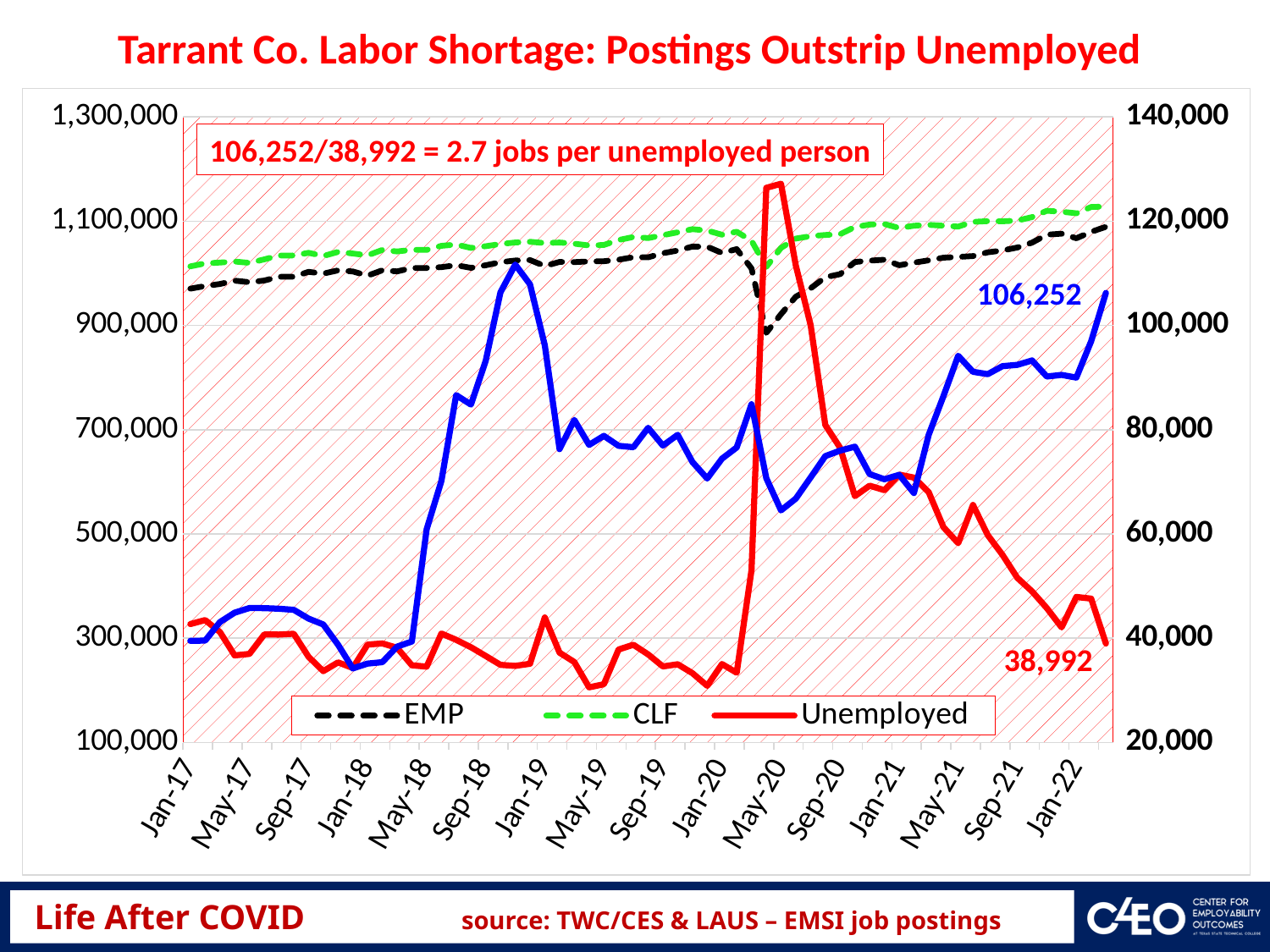
Is the CLF value at Jan-22 greater or less than 1,100,000 on the left axis? greater What kind of chart is shown on the slide? line chart What is the labeled final value of the blue job postings line? 106,252 Which line is consistently higher on the chart, CLF or EMP? CLF What is the difference between the labeled final job postings value (106,252) and the labeled final Unemployed value (38,992)? 67,260 What is the labeled final value of the Unemployed line? 38,992 Which is larger at the end of the chart: the labeled job postings value or the labeled Unemployed value? job postings (106,252) How many series does the legend list? 3 Does the CLF line generally rise or fall from Jan-17 to Jan-22? rise Is the EMP value at Jan-17 greater or less than 900,000 on the left axis? greater Is the peak of the Unemployed line around May-20 greater or less than 120,000 on the right axis? greater According to the annotation on the chart, how many jobs are there per unemployed person? 2.7